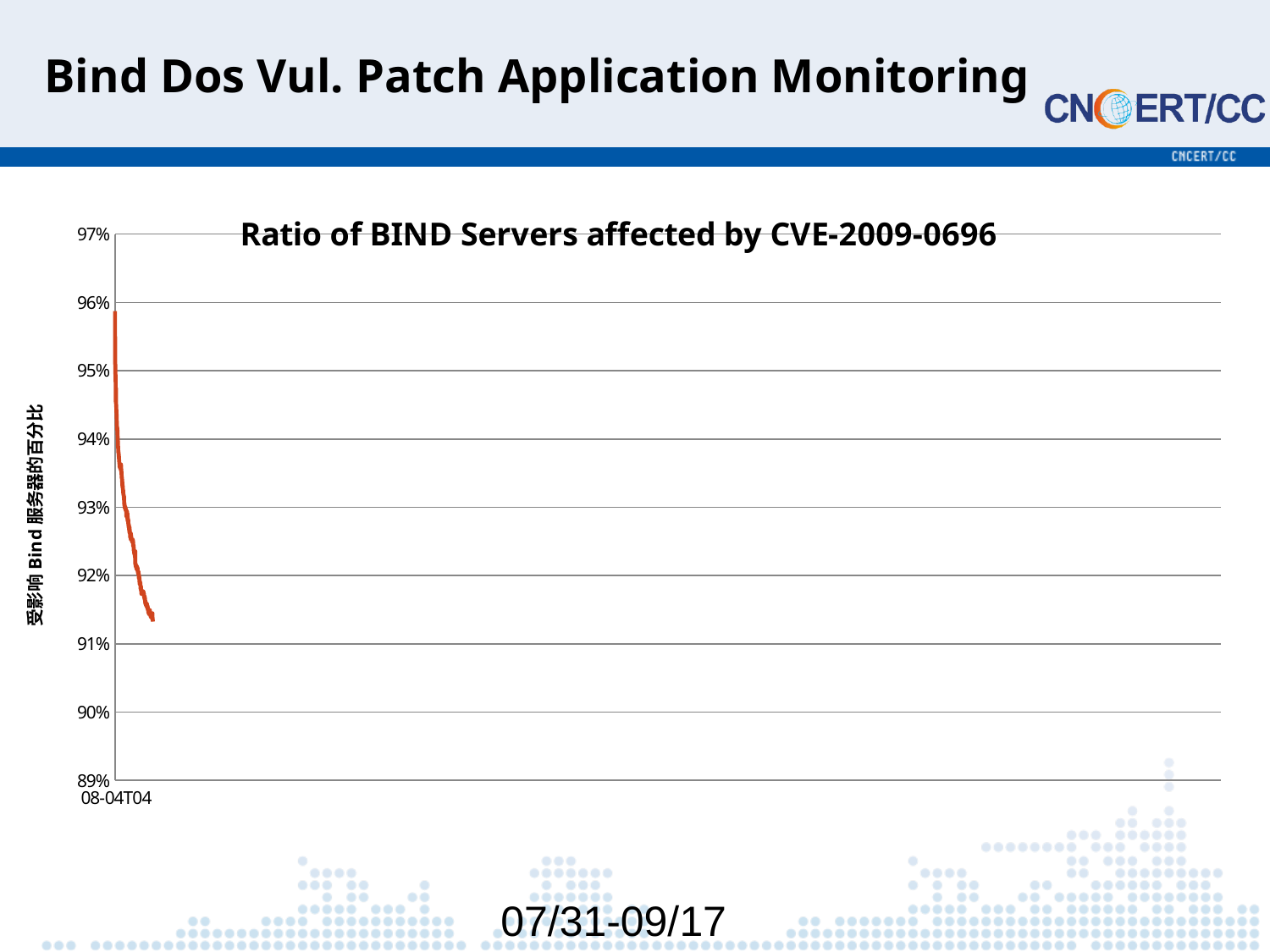
What is the only label shown on the x axis? 08-04T04 What kind of chart is shown on the slide? line chart Is the value at the end of the line greater or less than 91%? greater Is the value at the end of the line greater or less than 92%? less Does the plotted ratio rise or fall as it moves along the x axis? fall What is the title of the chart? Ratio of BIND Servers affected by CVE-2009-0696 What is the lowest value shown on the y axis? 89% Is the value at the start of the line greater or less than 96%? less